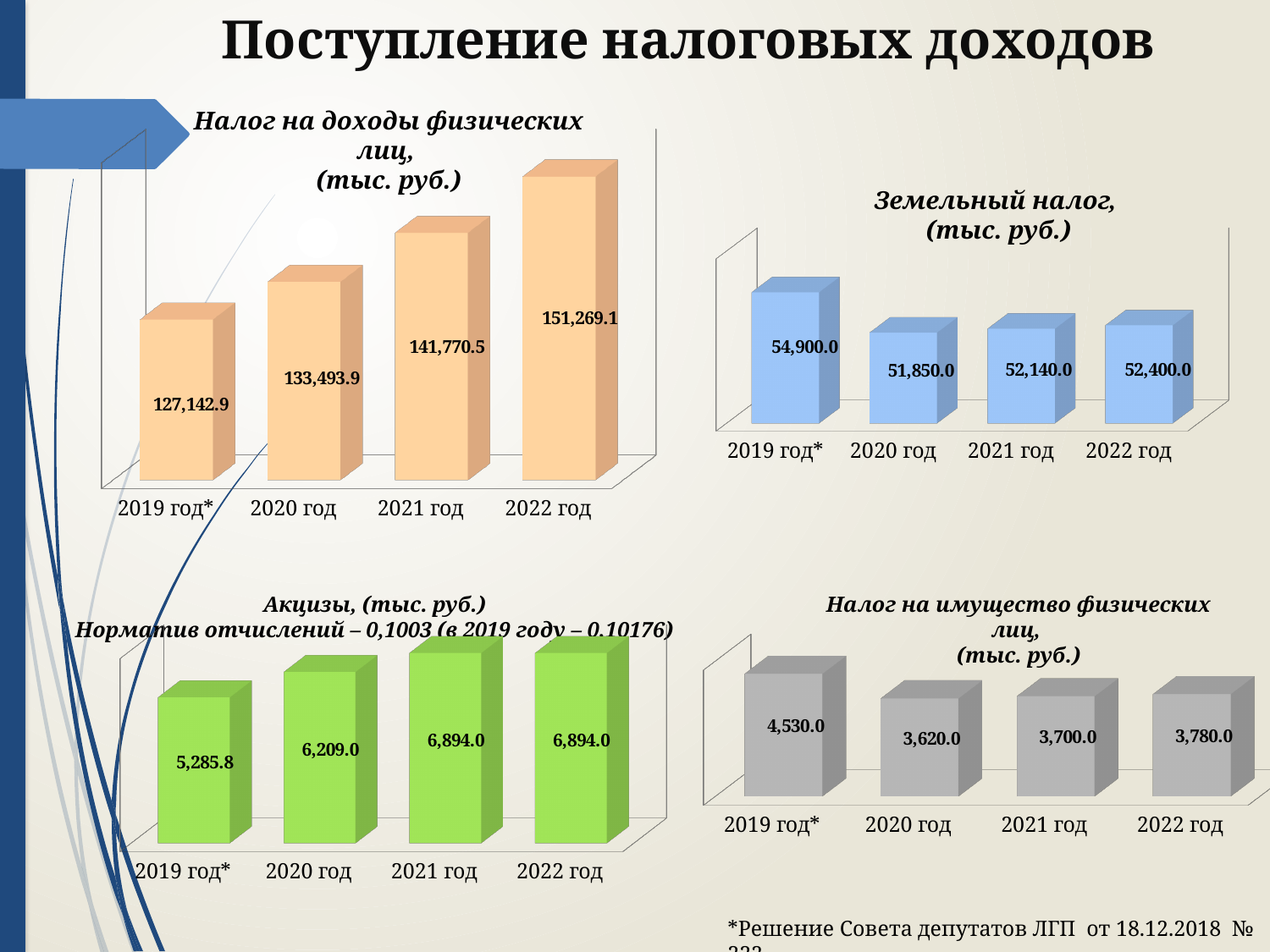
In the chart titled "Налог на имущество физических лиц, (тыс. руб.)", which is larger, the value for 2020 год or 2022 год? 2022 год In the chart titled "Налог на доходы физических лиц, (тыс. руб.)", do the values rise or fall from 2019 to 2022? rise In the chart titled "Земельный налог, (тыс. руб.)", what is the value for 2021 год? 52,140.0 In the chart titled "Земельный налог, (тыс. руб.)", which year has the highest value? 2019 год* In the chart titled "Налог на имущество физических лиц, (тыс. руб.)", what is the value for 2019 год*? 4,530.0 What kind of chart is the chart titled "Акцизы, (тыс. руб.)"? bar chart In the chart titled "Налог на доходы физических лиц, (тыс. руб.)", which year has the lowest value? 2019 год* In the chart titled "Налог на доходы физических лиц, (тыс. руб.)", what is the value for 2022 год? 151,269.1 In the chart titled "Налог на доходы физических лиц, (тыс. руб.)", what is the difference between the 2022 год and 2019 год* values? 24,126.2 In the chart titled "Земельный налог, (тыс. руб.)", what is the difference between the 2019 год* and 2020 год values? 3,050.0 In the chart titled "Акцизы, (тыс. руб.)", how many years are shown? 4 In the chart titled "Акцизы, (тыс. руб.)", what is the value for 2020 год? 6,209.0